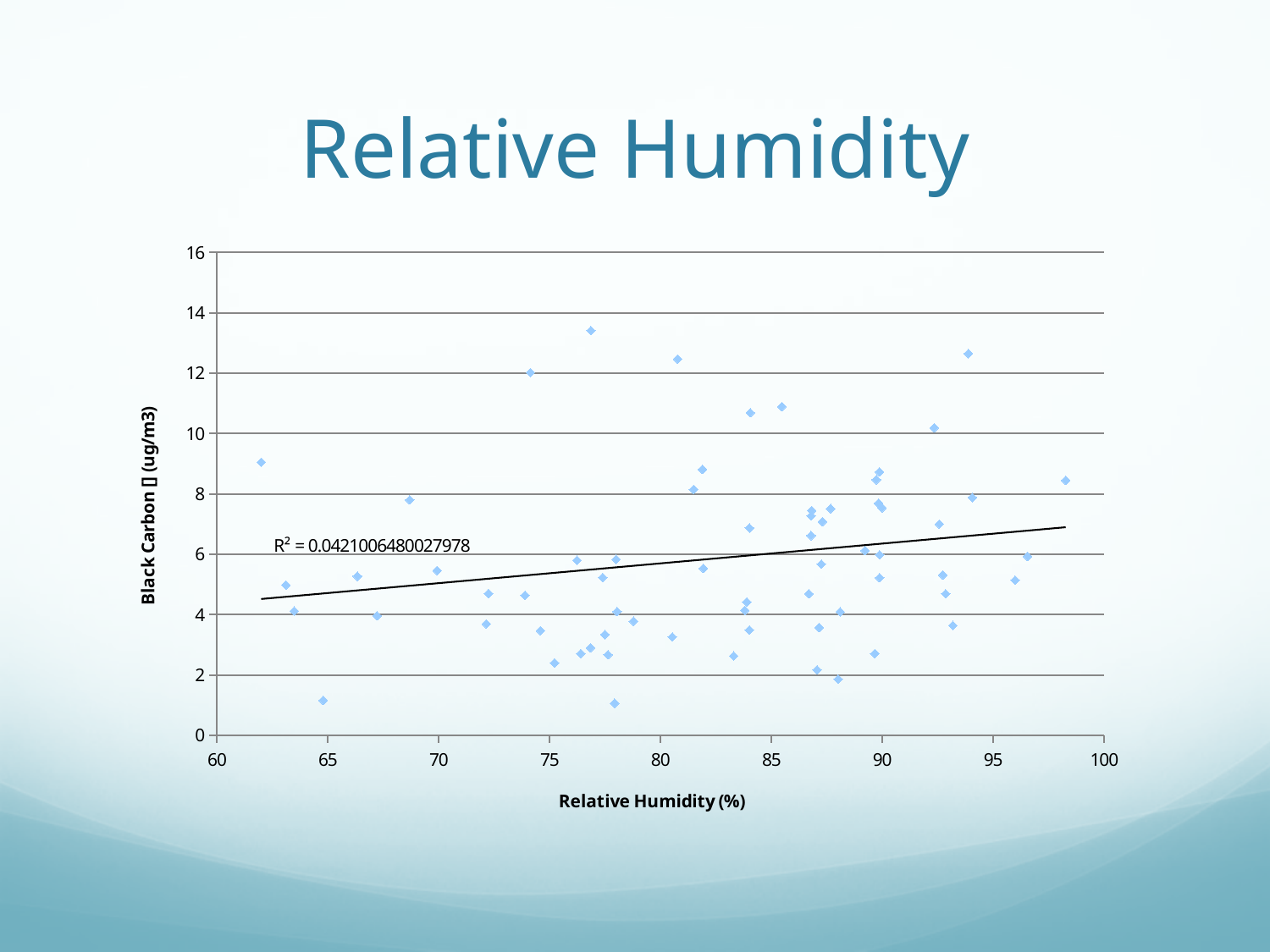
What kind of chart is shown on the slide? scatter chart Is the highest plotted black carbon value greater or less than 12? greater Is the trendline's value at its right end (near 98% relative humidity) greater or less than 6? greater Which is larger: the black carbon value of the point near 62% relative humidity or the point near 65% relative humidity? the point near 62% What R² value is printed on the chart? R² = 0.0421006480027978 What is the label of the x axis? Relative Humidity (%) What is the maximum value shown on the y axis? 16 Is the trendline's value at its left end (near 62% relative humidity) greater or less than 6? less What is the title of the chart? Relative Humidity Does the trendline rise or fall as relative humidity increases? rises What is the minimum value shown on the x axis? 60